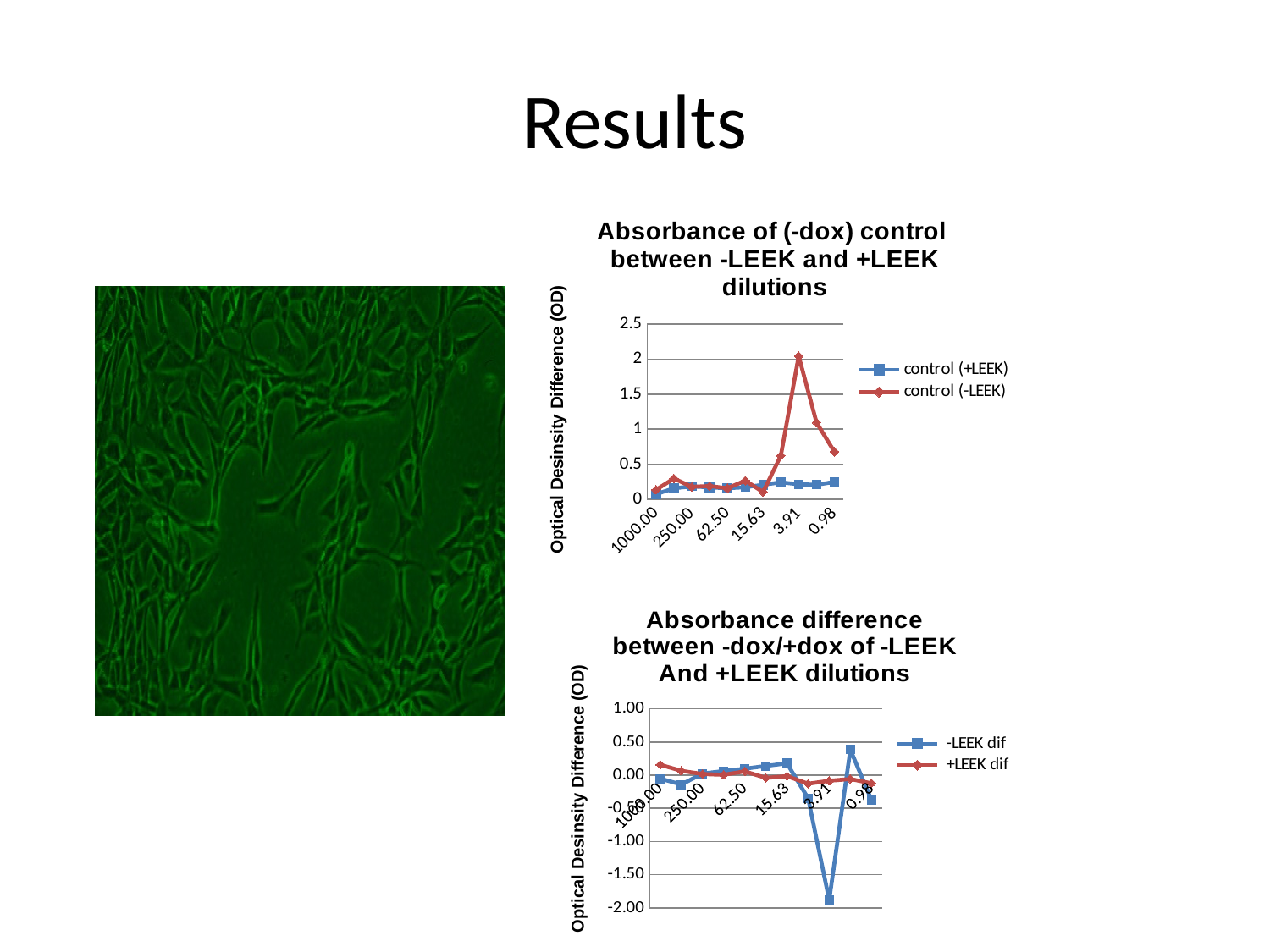
In the chart titled "Absorbance difference between -dox/+dox of -LEEK And +LEEK dilutions", is the lowest value of the -LEEK dif series greater or less than -1.50? less In the chart titled "Absorbance of (-dox) control between -LEEK and +LEEK dilutions", how many series does the legend list? 2 In the chart titled "Absorbance of (-dox) control between -LEEK and +LEEK dilutions", is the value of the control (+LEEK) series at 0.98 greater or less than 0.5? less In the chart titled "Absorbance of (-dox) control between -LEEK and +LEEK dilutions", is the peak value of the control (-LEEK) series greater or less than 1.5? greater In the chart titled "Absorbance difference between -dox/+dox of -LEEK And +LEEK dilutions", how many series does the legend list? 2 In the chart titled "Absorbance difference between -dox/+dox of -LEEK And +LEEK dilutions", which series has the lowest value on the chart? -LEEK dif In the chart titled "Absorbance difference between -dox/+dox of -LEEK And +LEEK dilutions", what are the two legend entries? -LEEK dif and +LEEK dif In the chart titled "Absorbance of (-dox) control between -LEEK and +LEEK dilutions", which series reaches the highest value? control (-LEEK) In the chart titled "Absorbance difference between -dox/+dox of -LEEK And +LEEK dilutions", what kind of chart is shown? line chart In the chart titled "Absorbance of (-dox) control between -LEEK and +LEEK dilutions", what kind of chart is shown? line chart In the chart titled "Absorbance difference between -dox/+dox of -LEEK And +LEEK dilutions", what is the highest value shown on the y-axis? 1.00 In the chart titled "Absorbance of (-dox) control between -LEEK and +LEEK dilutions", what is the y-axis label? Optical Desinsity Difference (OD)